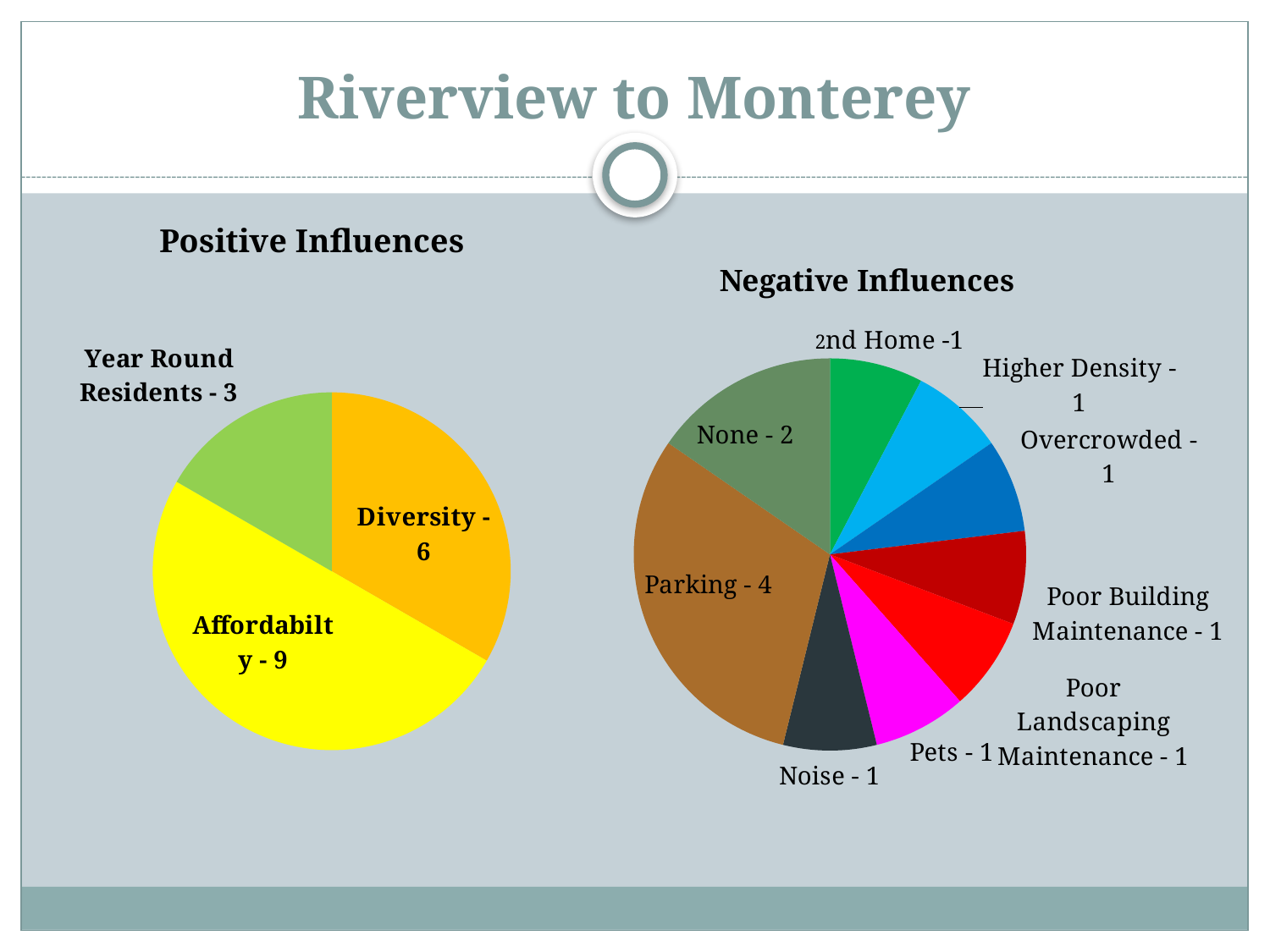
What type of chart is used for Positive Influences? Pie chart In the Positive Influences pie chart, what share of the total does Affordability represent? 50% In the Negative Influences pie chart, what is the value for Parking? 4 In the Positive Influences pie chart, what is the difference between Affordability and Diversity? 3 In the Positive Influences pie chart, what is the value for Affordability? 9 In the Negative Influences pie chart, how many categories are shown? 9 In the Negative Influences pie chart, what is the value for None? 2 In the Negative Influences pie chart, which category has the largest slice? Parking In the Positive Influences pie chart, what is the value for Year Round Residents? 3 In the Negative Influences pie chart, what is the difference between Parking and Noise? 3 In the Positive Influences pie chart, which category has the largest slice? Affordability In the Negative Influences pie chart, which is larger, Parking or None? Parking